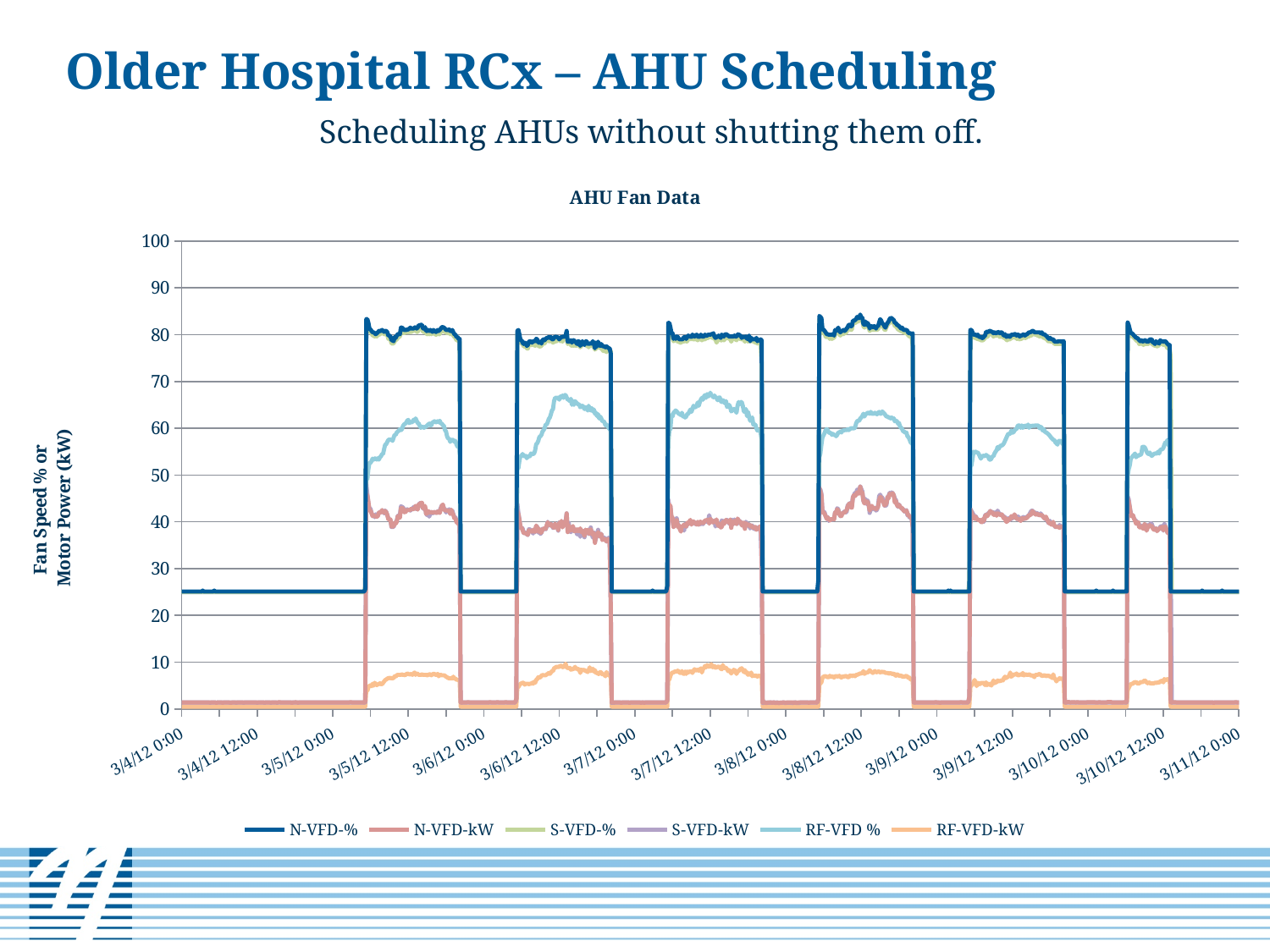
How many series does the legend list? 6 Is the value of RF-VFD % at 3/6/12 12:00 greater or less than 50? greater At 3/6/12 12:00, which is larger: RF-VFD % or N-VFD-kW? RF-VFD % Does N-VFD-% rise or fall between 3/5/12 0:00 and 3/5/12 12:00? rise What kind of chart is shown on the slide? line chart Is the value of N-VFD-% at 3/5/12 12:00 greater or less than 70? greater Is the value of RF-VFD-kW at 3/7/12 12:00 greater or less than 20? less How many date/time labels are shown on the x axis? 15 At 3/5/12 12:00, which is larger: N-VFD-% or N-VFD-kW? N-VFD-% What is the label on the vertical axis? Fan Speed % or Motor Power (kW) What is the title of the chart? AHU Fan Data